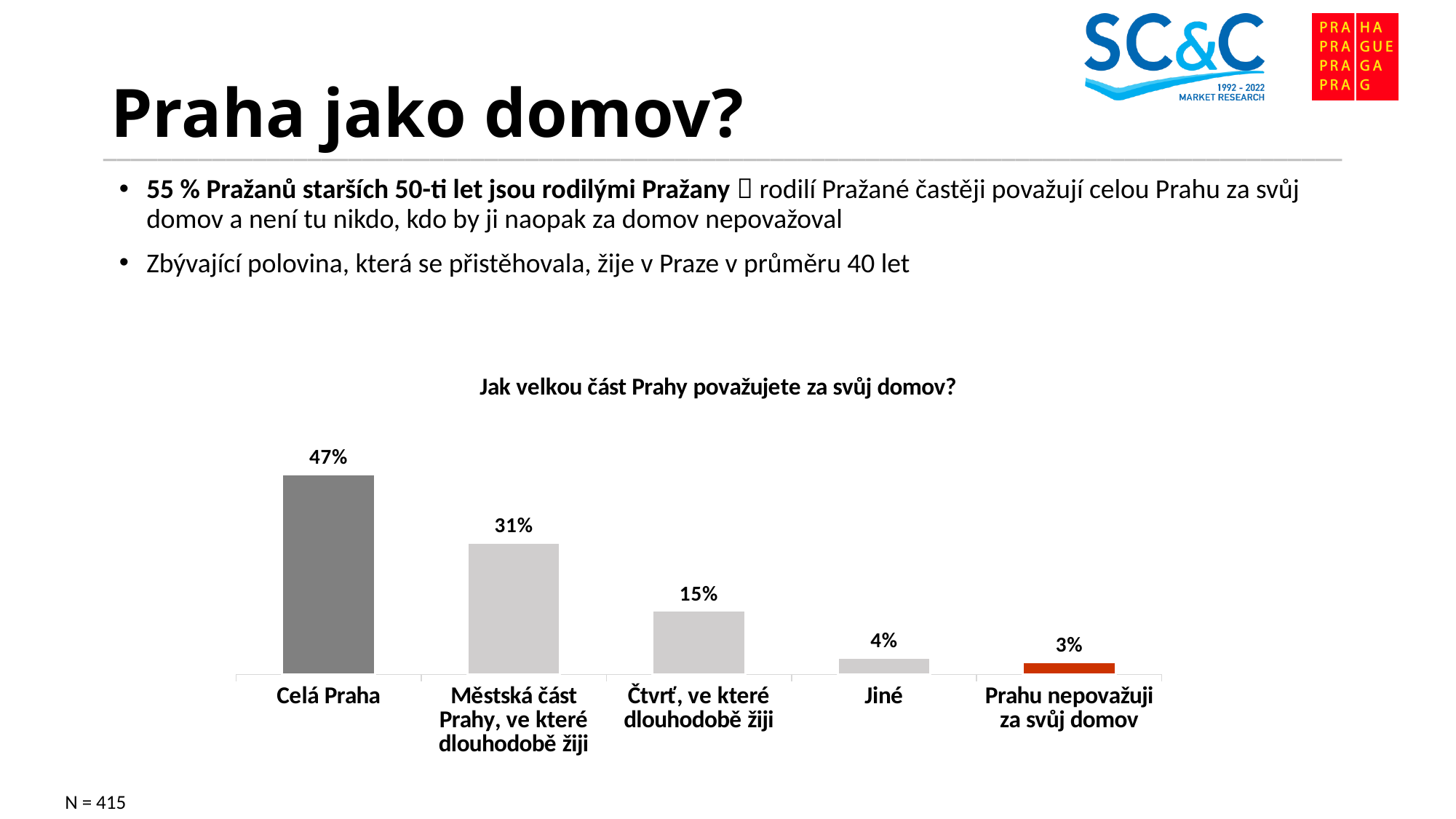
What is the value for "Celá Praha"? 47% What is the title of the chart? Jak velkou část Prahy považujete za svůj domov? What kind of chart is shown on the slide? Bar chart Which category has the lowest value? Prahu nepovažuji za svůj domov What is the value for "Čtvrť, ve které dlouhodobě žiji"? 15% What is the value for "Městská část Prahy, ve které dlouhodobě žiji"? 31% What is the value for "Prahu nepovažuji za svůj domov"? 3% Which is larger, the value for "Čtvrť, ve které dlouhodobě žiji" or the value for "Jiné"? Čtvrť, ve které dlouhodobě žiji What is the difference between the values for "Celá Praha" and "Městská část Prahy, ve které dlouhodobě žiji"? 16% How many categories are shown in the chart? 5 Which category has the highest value? Celá Praha Do the values rise or fall from left to right along the x axis? Fall